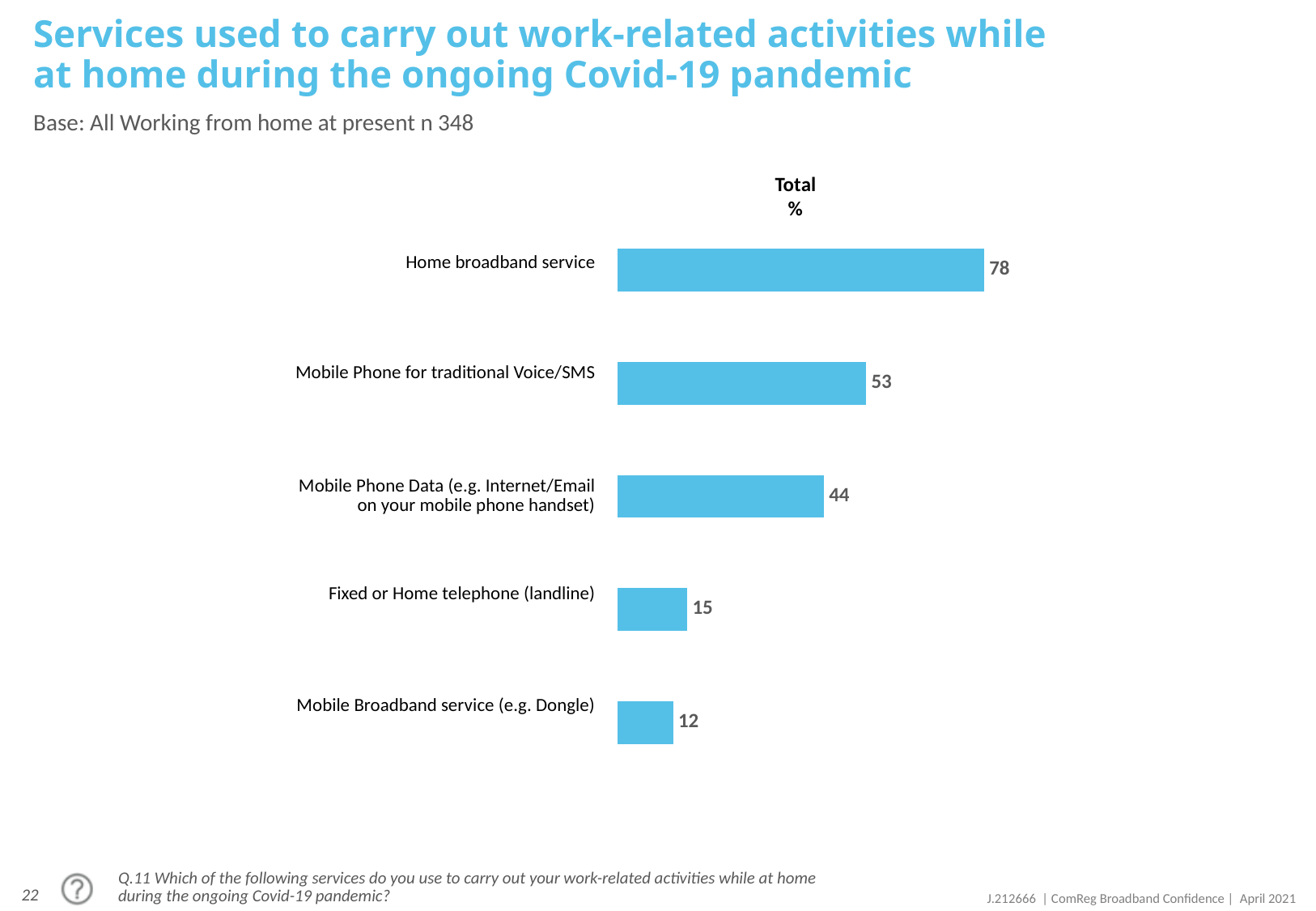
Which is larger: the value for Mobile Phone Data or the value for Fixed or Home telephone (landline)? Mobile Phone Data What is the value for Mobile Phone Data (e.g. Internet/Email on your mobile phone handset)? 44 How many services are shown in the chart? 5 What kind of chart is shown on the slide? Bar chart What is the value for Home broadband service? 78 Which service has the highest value? Home broadband service What is the value for Mobile Broadband service (e.g. Dongle)? 12 What is the column header shown above the bars? Total % Which service has the lowest value? Mobile Broadband service (e.g. Dongle) What is the value for Mobile Phone for traditional Voice/SMS? 53 What is the value for Fixed or Home telephone (landline)? 15 What is the difference between the values for Home broadband service and Mobile Phone for traditional Voice/SMS? 25